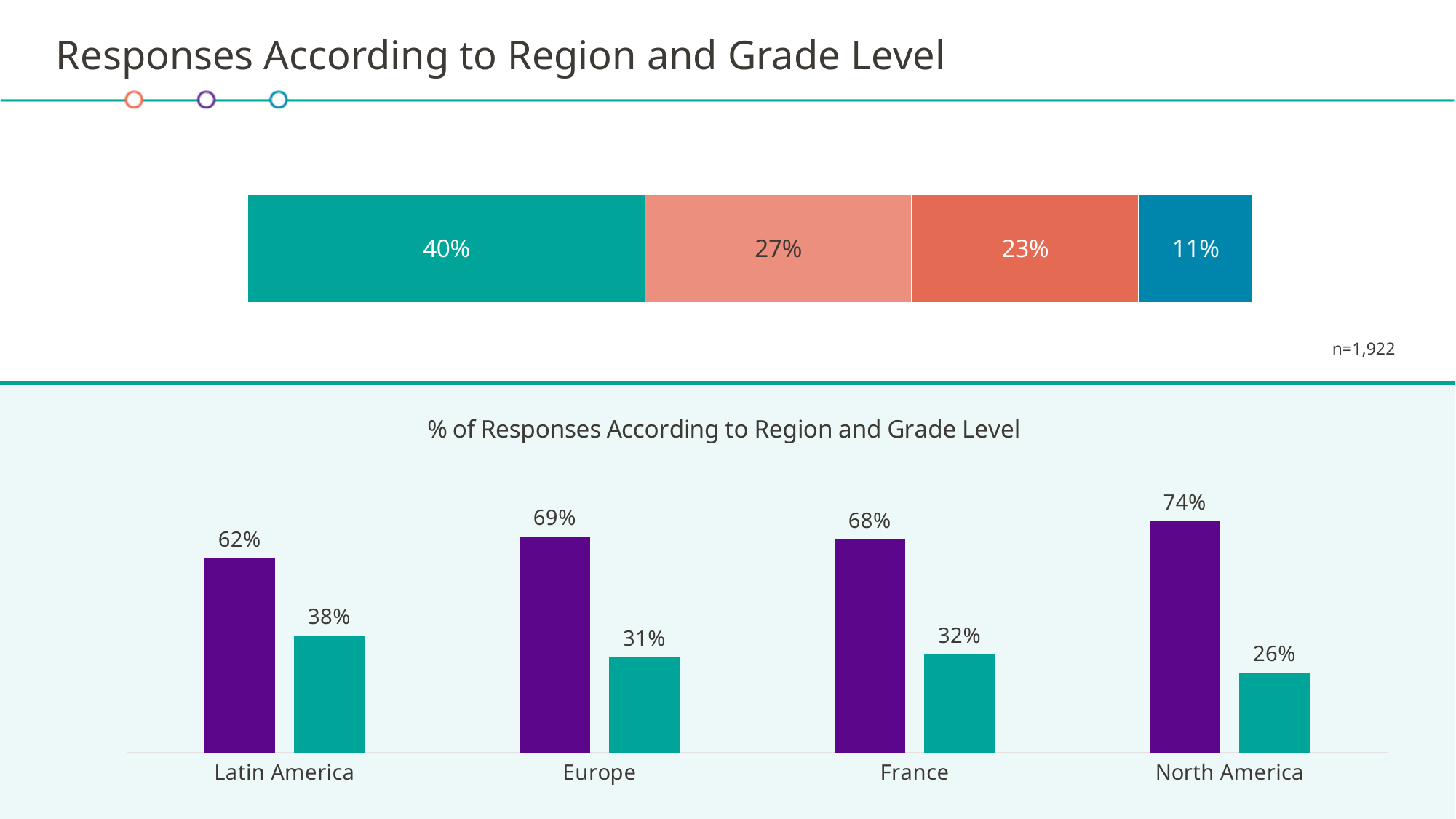
In the top stacked bar chart, how many segments make up the bar? 4 In the bottom chart titled '% of Responses According to Region and Grade Level', is the purple bar for Europe or the purple bar for France larger? Europe What sample size (n) is shown on the slide below the top stacked bar chart? n=1,922 In the bottom chart titled '% of Responses According to Region and Grade Level', how many regions are shown on the x axis? 4 In the bottom chart titled '% of Responses According to Region and Grade Level', which region has the lowest teal bar? North America In the bottom chart titled '% of Responses According to Region and Grade Level', which region has the highest purple bar? North America In the bottom chart titled '% of Responses According to Region and Grade Level', what is the value of the teal bar for Europe? 31% In the bottom chart titled '% of Responses According to Region and Grade Level', what is the value of the purple bar for North America? 74% What kind of chart is the bottom chart titled '% of Responses According to Region and Grade Level'? Bar chart In the top stacked bar chart, what is the value of the largest (leftmost, teal) segment? 40% In the top stacked bar chart, what is the value of the smallest (rightmost, blue) segment? 11% In the bottom chart titled '% of Responses According to Region and Grade Level', what is the difference between the purple and teal bars for Latin America? 24%